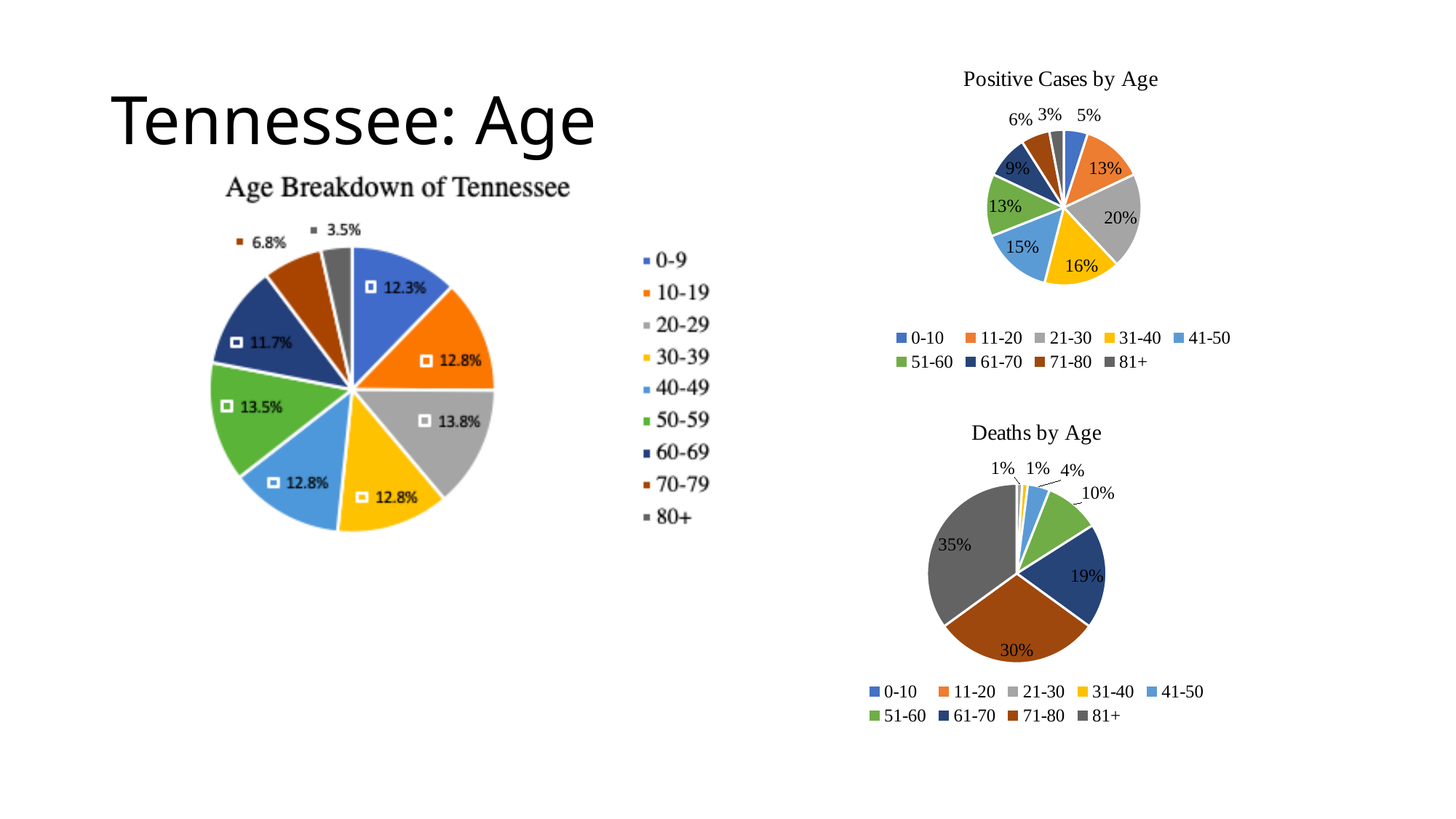
In the 'Age Breakdown of Tennessee' chart, what is the difference between the 60-69 share and the 70-79 share? 4.9% In the 'Age Breakdown of Tennessee' chart, what share is the 20-29 age group? 13.8% In the 'Deaths by Age' chart, what share is the 81+ age group? 35% In the 'Positive Cases by Age' chart, how many age groups does the legend list? 9 In the 'Positive Cases by Age' chart, which age group has the smallest share? 81+ In the 'Deaths by Age' chart, what share is the 61-70 age group? 19% In the 'Positive Cases by Age' chart, what share is the 21-30 age group? 20% In the 'Age Breakdown of Tennessee' chart, what share is the 80+ age group? 3.5% In the 'Age Breakdown of Tennessee' chart, which age group has the largest share? 20-29 In the 'Deaths by Age' chart, what is the combined share of the 71-80 and 81+ age groups? 65% What type of chart is 'Deaths by Age'? Pie chart In the 'Deaths by Age' chart, which is larger, the 71-80 share or the 51-60 share? 71-80